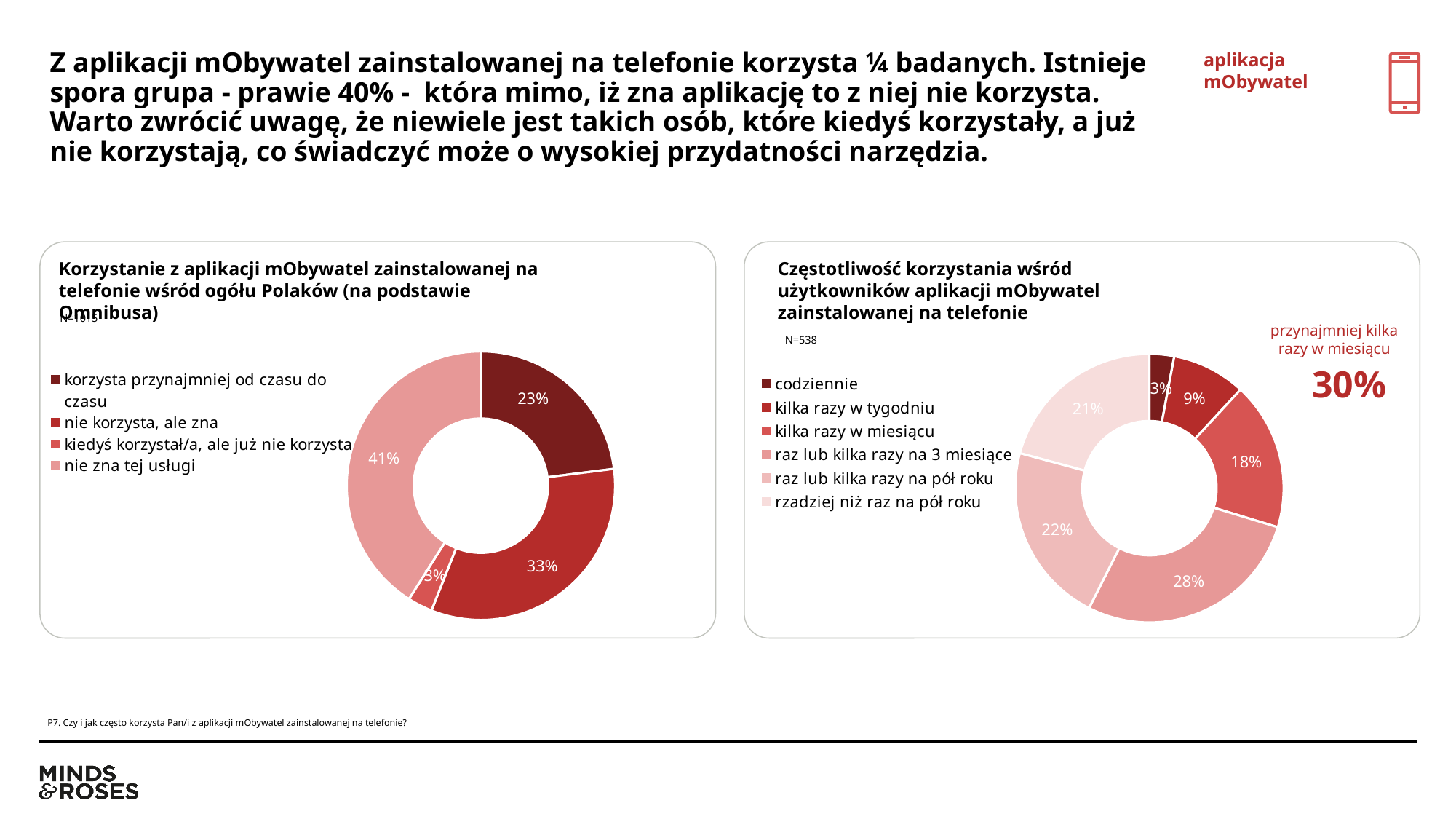
In the left chart (Korzystanie z aplikacji mObywatel...), what is the difference between 'nie zna tej usługi' and 'korzysta przynajmniej od czasu do czasu'? 18 percentage points What is the sample size (N) shown for the right chart (Częstotliwość korzystania...)? N=538 In the left chart (Korzystanie z aplikacji mObywatel...), how many categories does the legend list? 4 In the right chart (Częstotliwość korzystania...), what percentage is shown for 'raz lub kilka razy na 3 miesiące'? 28% What type of chart is used in the right panel (Częstotliwość korzystania wśród użytkowników aplikacji mObywatel)? Donut (pie) chart In the right chart (Częstotliwość korzystania...), which is larger: 'kilka razy w miesiącu' or 'kilka razy w tygodniu'? kilka razy w miesiącu In the left chart (Korzystanie z aplikacji mObywatel...), what percentage is shown for 'nie korzysta, ale zna'? 33% In the right chart (Częstotliwość korzystania...), how many categories does the legend list? 6 In the right chart (Częstotliwość korzystania...), which category has the largest share? raz lub kilka razy na 3 miesiące In the left chart (Korzystanie z aplikacji mObywatel zainstalowanej na telefonie wśród ogółu Polaków), what percentage is shown for 'nie zna tej usługi'? 41% In the left chart (Korzystanie z aplikacji mObywatel...), which category has the smallest share? kiedyś korzystał/a, ale już nie korzysta In the right chart (Częstotliwość korzystania...), what percentage of users use the app 'codziennie'? 3%